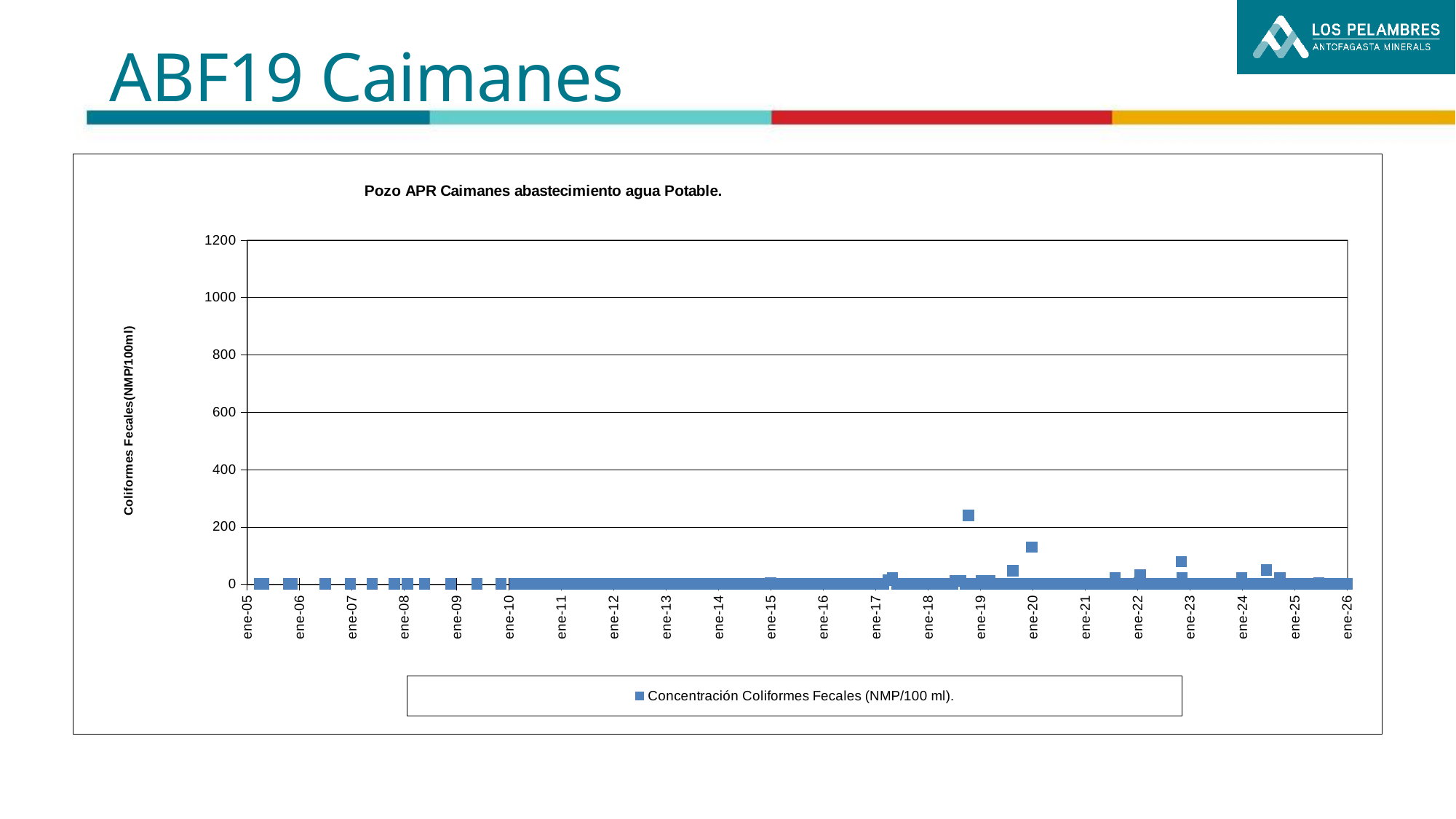
What is the first label on the x axis? ene-05 What is the label of the y axis? Coliformes Fecales(NMP/100ml) What is the maximum value shown on the y axis? 1200 What is the title of the chart? Pozo APR Caimanes abastecimiento agua Potable. Is the highest plotted value greater or less than 400? less Is the highest plotted value greater or less than 200? greater What kind of chart is shown on the slide? scatter chart Which is larger, the highest point near ene-19 or the highest point near ene-20? ene-19 Near which x-axis label does the highest plotted point occur? ene-19 How many series does the legend list? 1 Is the plotted value near ene-20 greater or less than 200? less